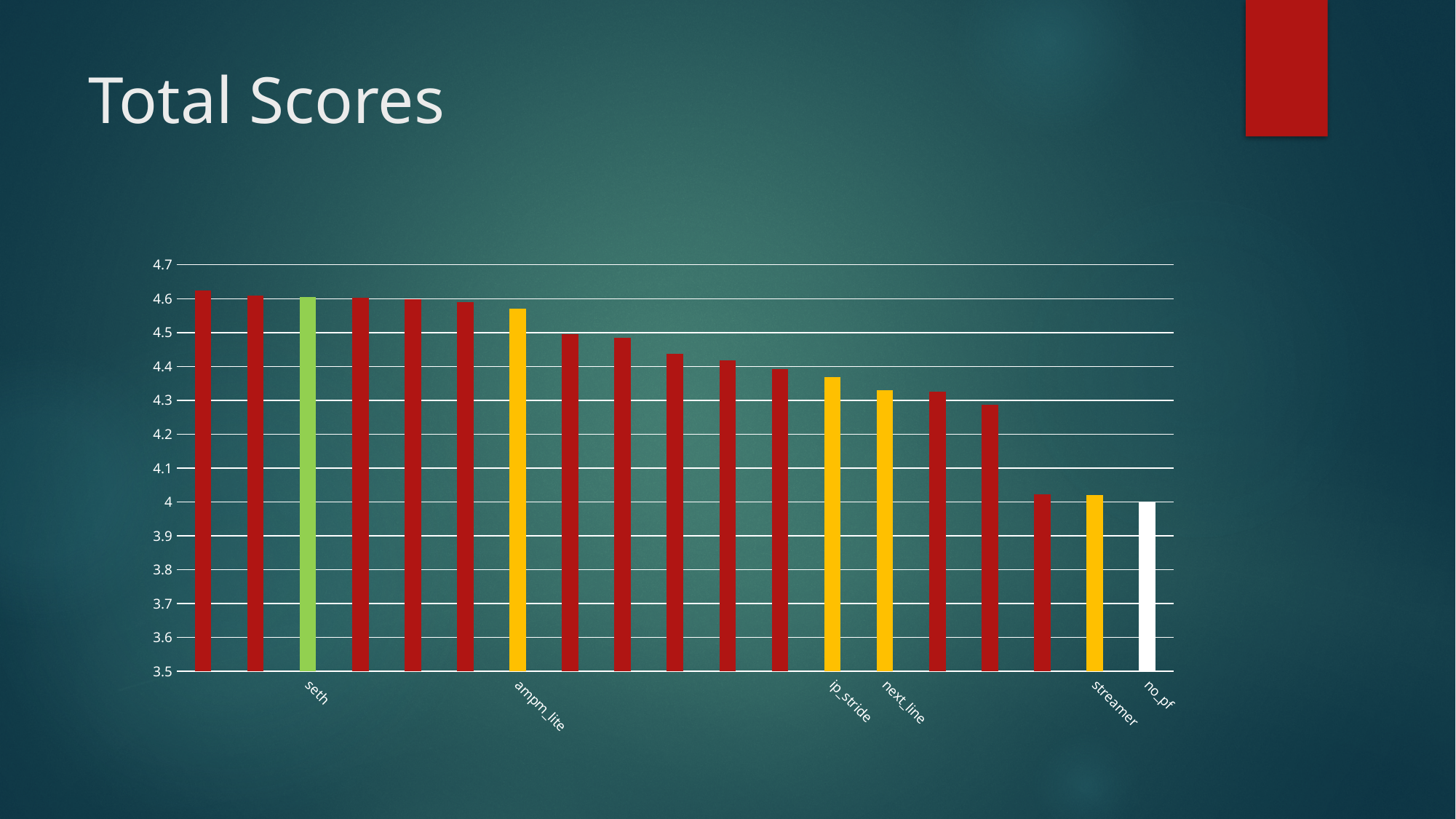
Is the value for streamer greater or less than 4.1? less How many bars are plotted in the chart? 19 Is the value for seth greater or less than 4.5? greater What kind of chart is shown on the slide? bar chart Which has the larger value, seth or streamer? seth What is the title of the chart? Total Scores Is the value for ampm_lite greater or less than 4.5? greater Which has the larger value, seth or ampm_lite? seth Do the values rise or fall moving from left to right along the x axis? fall What colour is the bar for no_pf? white